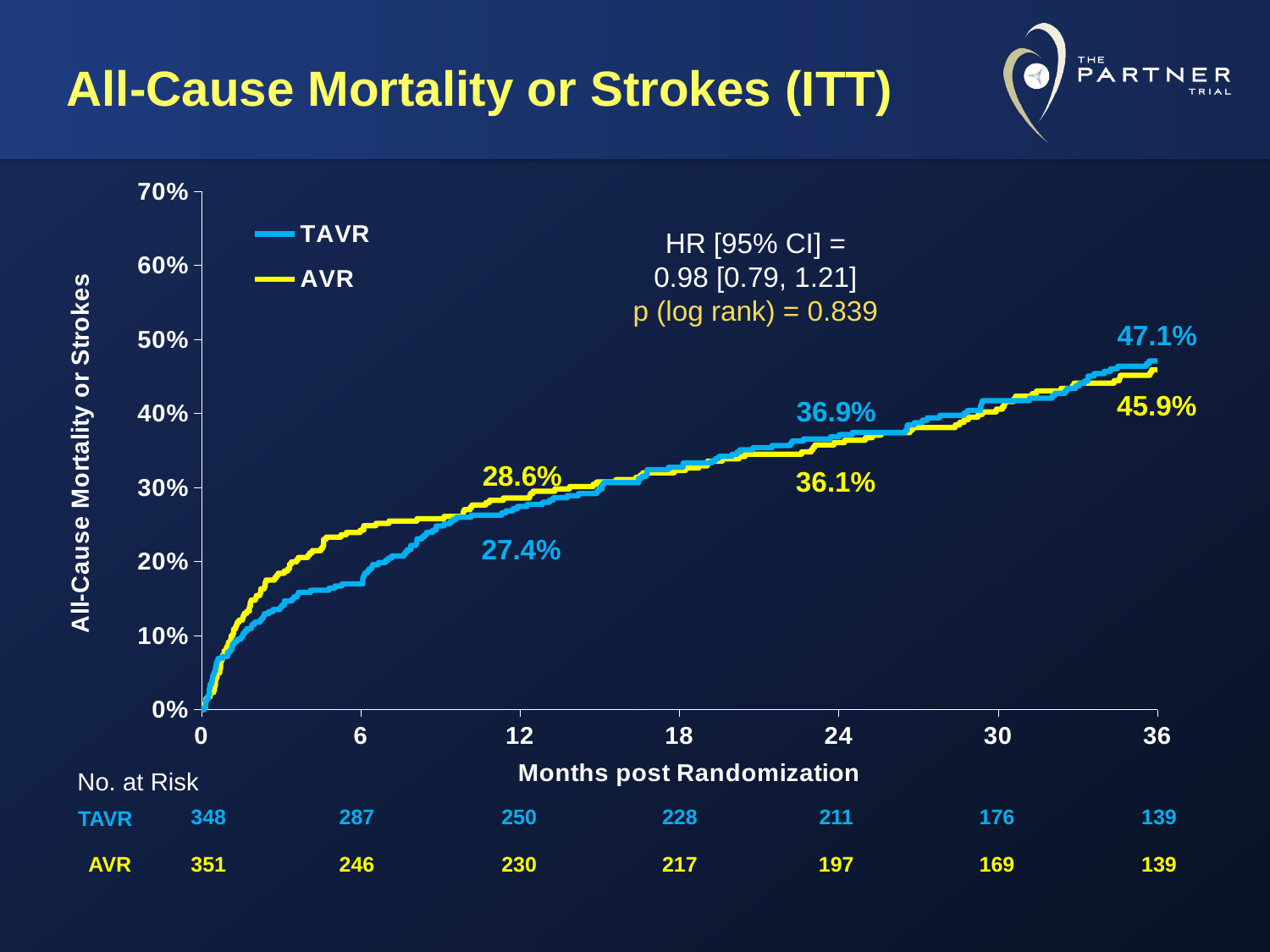
What is the difference between the AVR and TAVR values at 12 months? 1.2% Do the values rise or fall along the x axis? rise What is the value for TAVR at 36 months? 47.1% Which series has the higher value at 24 months, TAVR or AVR? TAVR What is the difference between the TAVR and AVR values at 36 months? 1.2% Is the value for TAVR at 6 months greater or less than 20%? less What is the value for AVR at 12 months? 28.6% How many series does the legend list? 2 Which series has the higher value at 12 months, TAVR or AVR? AVR What is the value for TAVR at 24 months? 36.9% What kind of chart is shown on the slide? line chart What is the value for AVR at 36 months? 45.9%